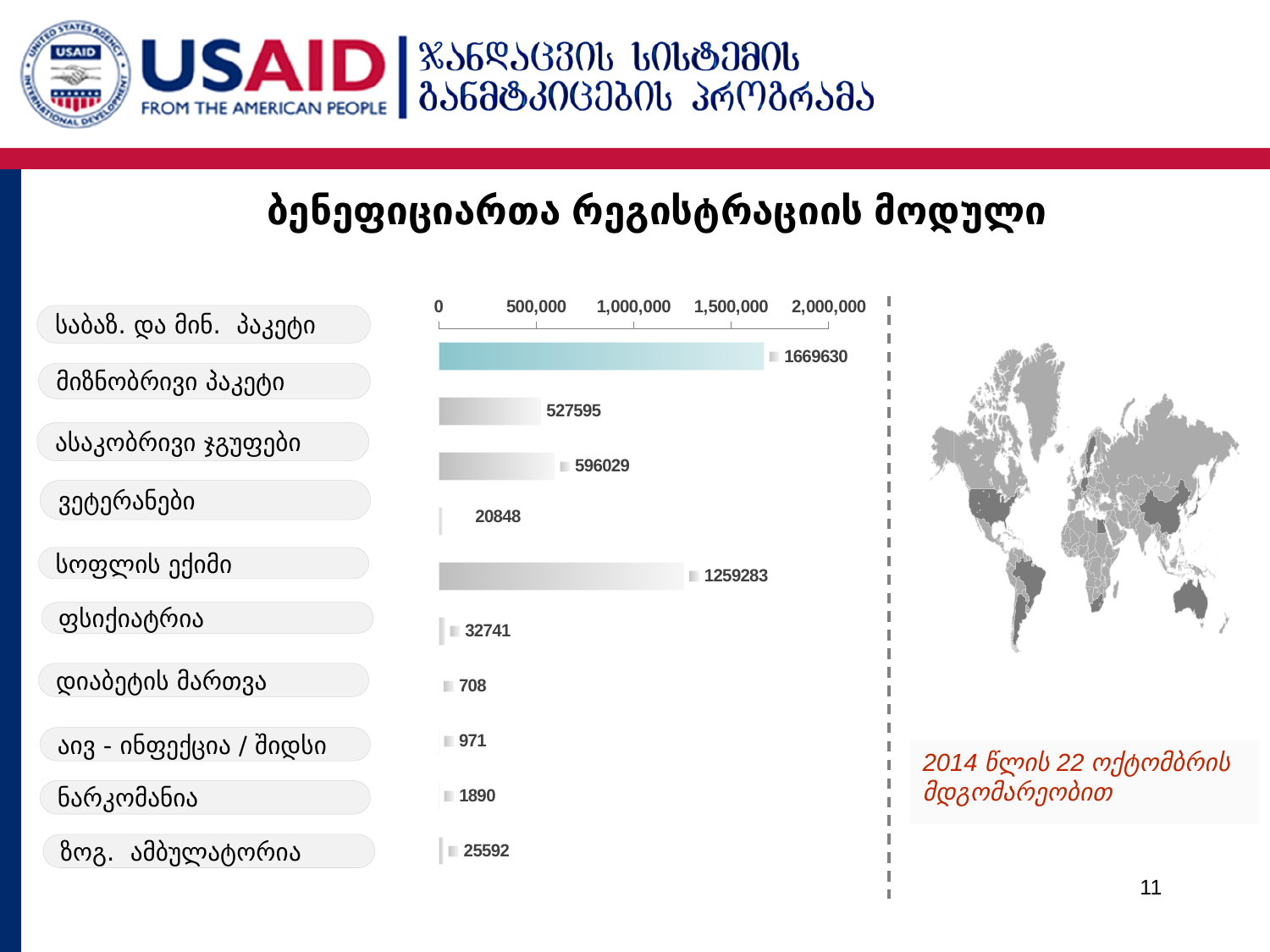
What kind of chart is shown on the slide? bar chart What is the highest tick value shown on the chart's axis? 2,000,000 How many categories are shown in the chart? 10 What is the value for საბაზ. და მინ. პაკეტი? 1669630 What is the difference between the values for ასაკობრივი ჯგუფები and მიზნობრივი პაკეტი? 68434 Which category has the highest value? საბაზ. და მინ. პაკეტი What is the value for ვეტერანები? 20848 Which category has the lowest value? დიაბეტის მართვა What is the value for სოფლის ექიმი? 1259283 What is the value for დიაბეტის მართვა? 708 Is the value for სოფლის ექიმი greater or less than 1,000,000? greater Which is larger, the value for ნარკომანია or the value for აივ - ინფექცია / შიდსი? ნარკომანია